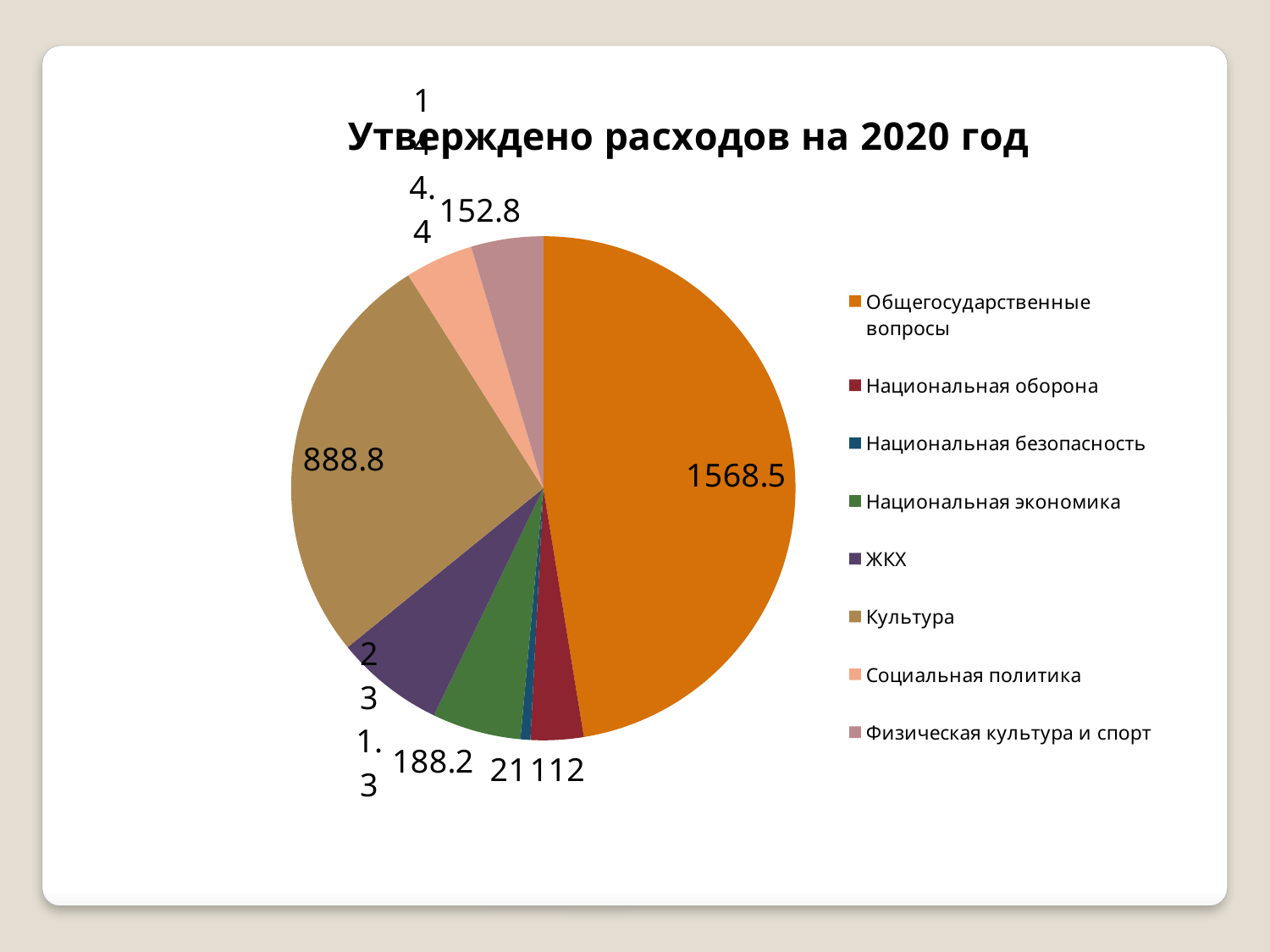
What kind of chart is shown on the slide? pie chart How many categories does the legend list? 8 What is the title of the chart? Утверждено расходов на 2020 год Which category has the largest slice? Общегосударственные вопросы Which category has the smallest slice? Национальная безопасность What is the value for Национальная безопасность? 21 What is the value for Культура? 888.8 What is the value for Физическая культура и спорт? 152.8 What is the value for Национальная экономика? 188.2 What is the difference between the values for Общегосударственные вопросы and Культура? 679.7 What is the value for Общегосударственные вопросы? 1568.5 What is the value for Национальная оборона? 112